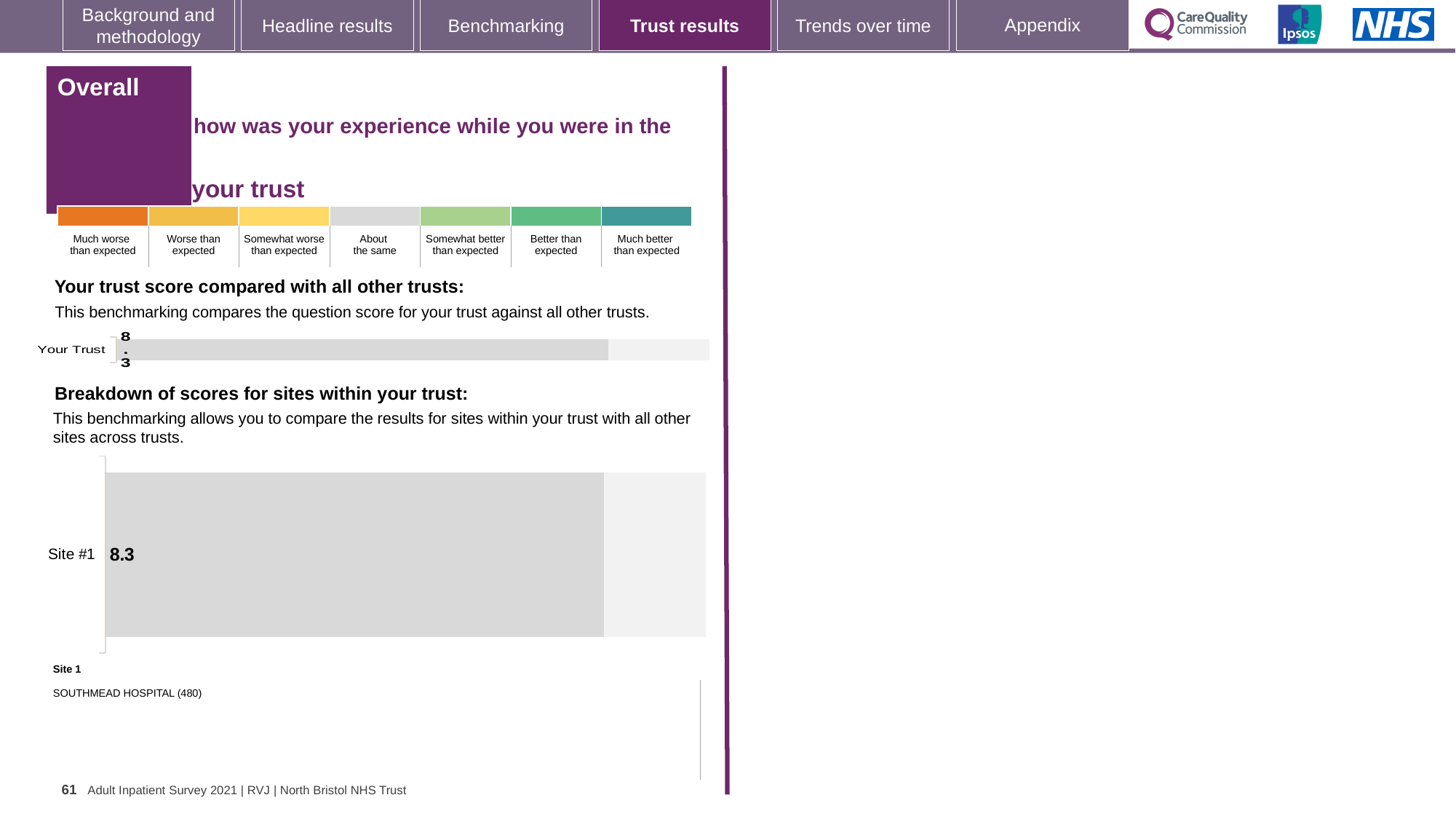
In the 'Breakdown of scores for sites within your trust' chart, which hospital does Site 1 refer to? SOUTHMEAD HOSPITAL (480) In the 'Your trust score compared with all other trusts' chart, what is the score for Your Trust? 8.3 What kind of chart is the 'Your trust score compared with all other trusts' chart? Bar chart In the 'Breakdown of scores for sites within your trust' chart, what is the score for Site #1? 8.3 Is the score for Site #1 in the 'Breakdown of scores for sites within your trust' chart the same as the Your Trust score in the chart above it? Yes What kind of chart is the 'Breakdown of scores for sites within your trust' chart? Bar chart How many sites are plotted in the 'Breakdown of scores for sites within your trust' chart? 1 What is the difference between the Your Trust score and the Site #1 score on this slide? 0.0 How many bars are plotted in the 'Your trust score compared with all other trusts' chart? 1 According to the colour key on the slide, which category does the grey bar colour represent? About the same